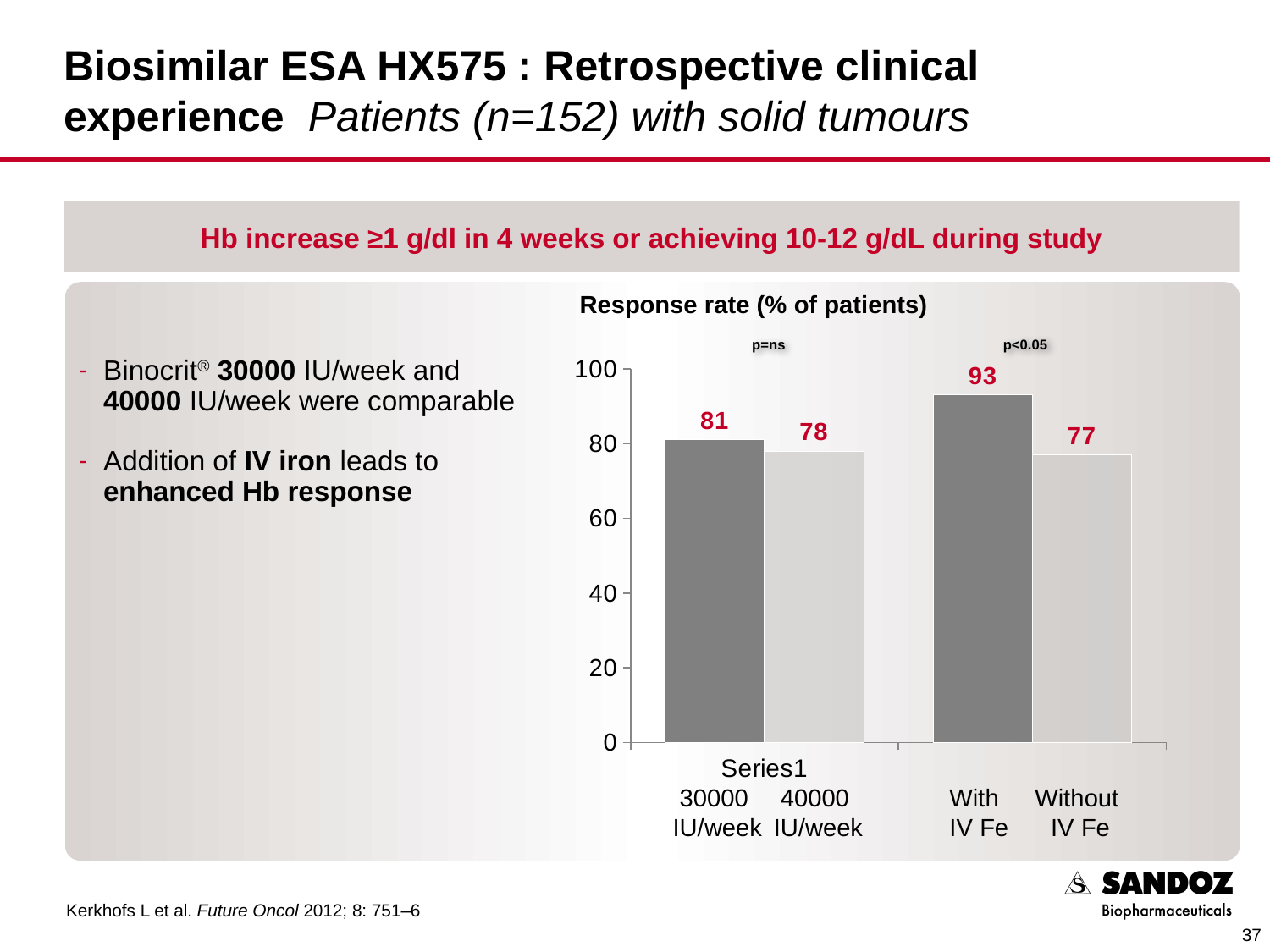
What is the title of the chart? Response rate (% of patients) What is the response rate for 30000 IU/week? 81 What is the response rate for patients Without IV Fe? 77 What is the difference in response rate between With IV Fe and Without IV Fe? 16 What is the response rate for 40000 IU/week? 78 Which has a higher response rate, 30000 IU/week or 40000 IU/week? 30000 IU/week What type of chart is shown on the slide? Bar chart Which bar has the highest response rate? With IV Fe What is the response rate for patients With IV Fe? 93 Which bar has the lowest response rate? Without IV Fe How many bars are plotted in the chart? 4 What is the difference in response rate between 30000 IU/week and 40000 IU/week? 3